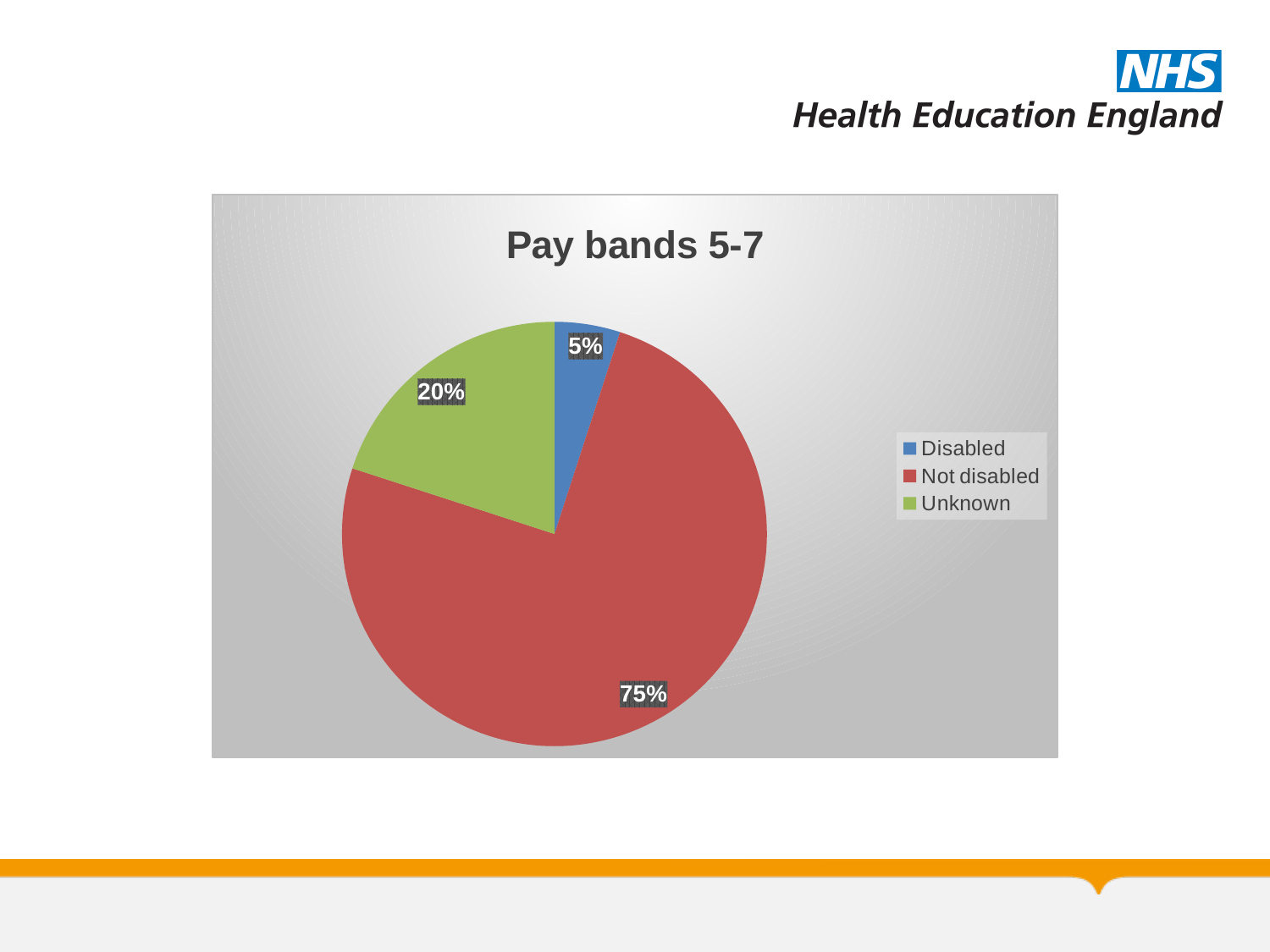
What share of the pie is labelled Disabled? 5% What kind of chart is shown on the slide? pie chart What colour is the Not disabled slice? red Which category has the largest slice of the pie? Not disabled What share of the pie is labelled Not disabled? 75% What is the difference in percentage points between the Not disabled and Unknown slices? 55 Which category has the smallest slice of the pie? Disabled How many entries does the legend list? 3 What is the title of the chart? Pay bands 5-7 What share of the pie is labelled Unknown? 20% Which slice is larger, Unknown or Disabled? Unknown How many slices does the pie chart have? 3